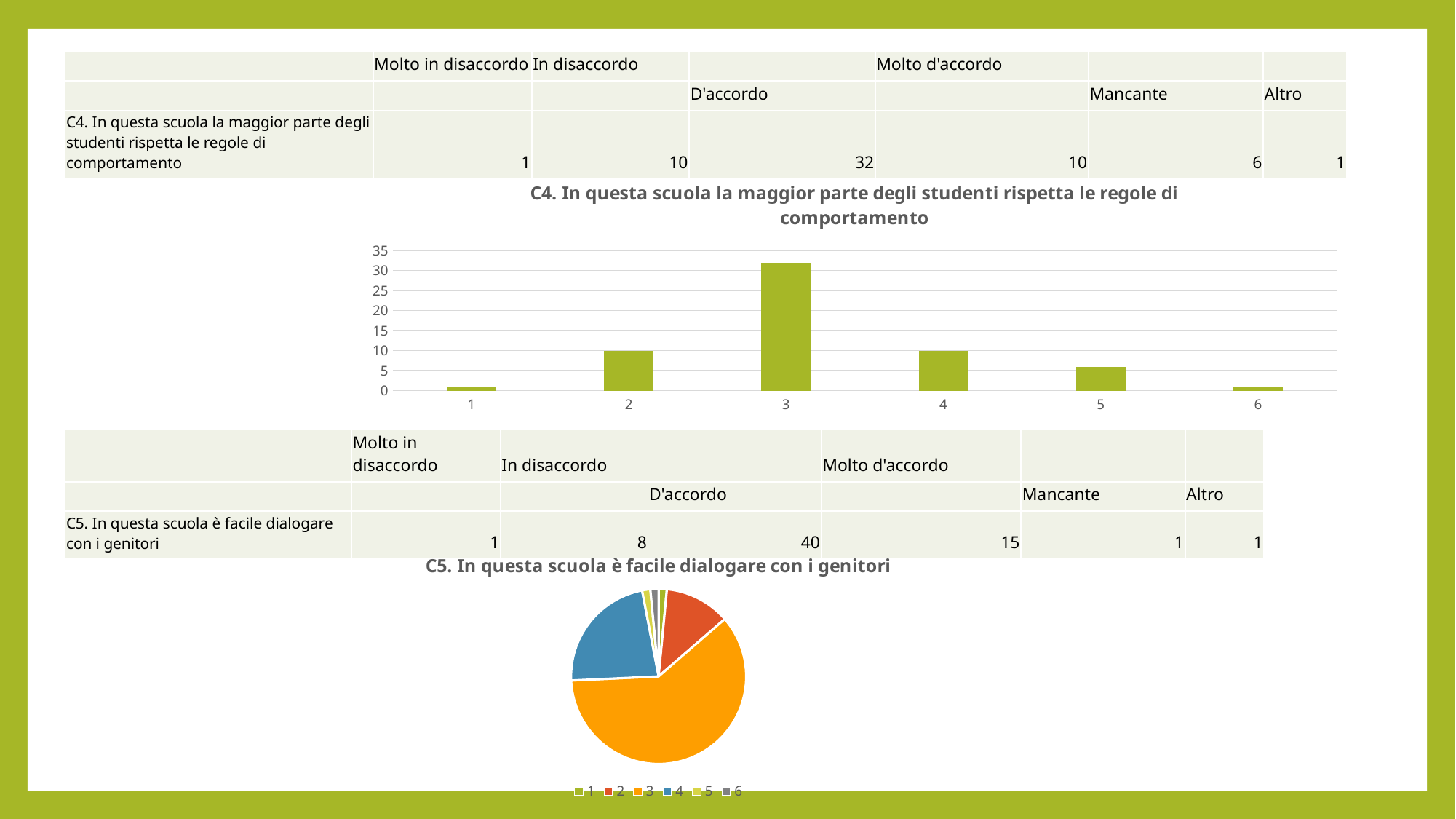
In the C4 bar chart, how many categories are shown on the x axis? 6 In the C4 bar chart, what is the difference between the values for category 3 and category 4? 22 In the C5 pie chart, which legend entry corresponds to the largest slice? 3 In the C4 bar chart, what is the value for category 3? 32 In the C4 bar chart, which is larger, the value for category 5 or the value for category 6? category 5 In the C4 bar chart, is the value for category 3 greater or less than 30? greater What type of chart is the C4 chart, 'In questa scuola la maggior parte degli studenti rispetta le regole di comportamento'? bar chart In the C4 bar chart, which category has the highest value? 3 In the C4 bar chart, what is the value for category 2? 10 What type of chart is the C5 chart, 'In questa scuola è facile dialogare con i genitori'? pie chart In the C5 pie chart, how many entries does the legend list? 6 In the C4 bar chart, what is the value for category 5? 6